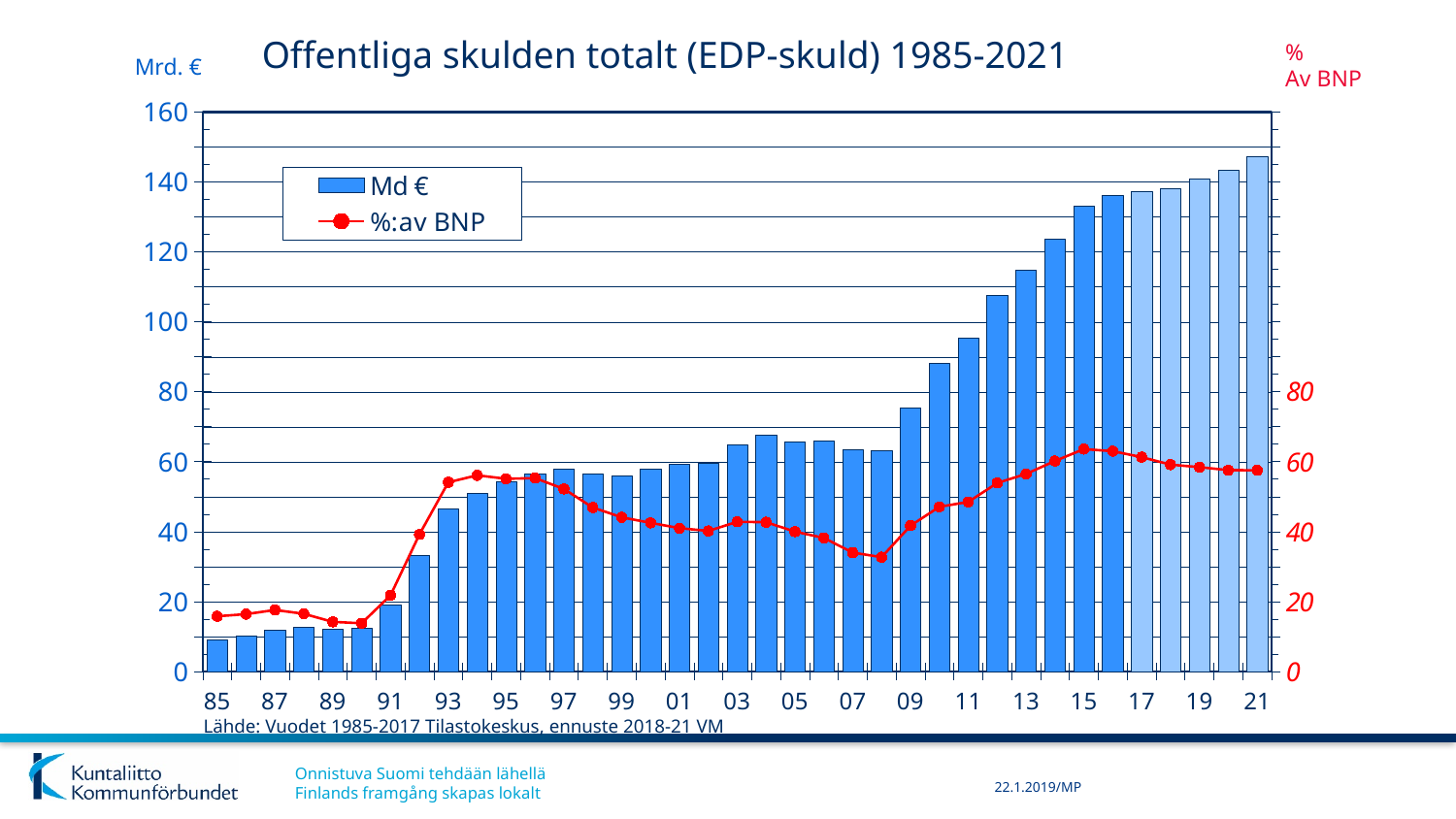
Is the Md € value for 2009 greater or less than 80? less What kind of chart is shown on the slide? A combined bar and line chart What is the title of the chart? Offentliga skulden totalt (EDP-skuld) 1985-2021 Which year has the lowest Md € bar? 1985 Which year has the larger Md € bar, 2005 or 2010? 2010 Is the Md € value for 2021 greater or less than 140? greater How many years (bars) are plotted in the chart? 37 What are the two series named in the legend? Md € and %:av BNP Which year has the highest Md € bar? 2021 Is the %:av BNP value for 2008 greater or less than 40? less Do the Md € bars generally rise or fall from 1985 to 2021? rise How many series does the legend list? 2